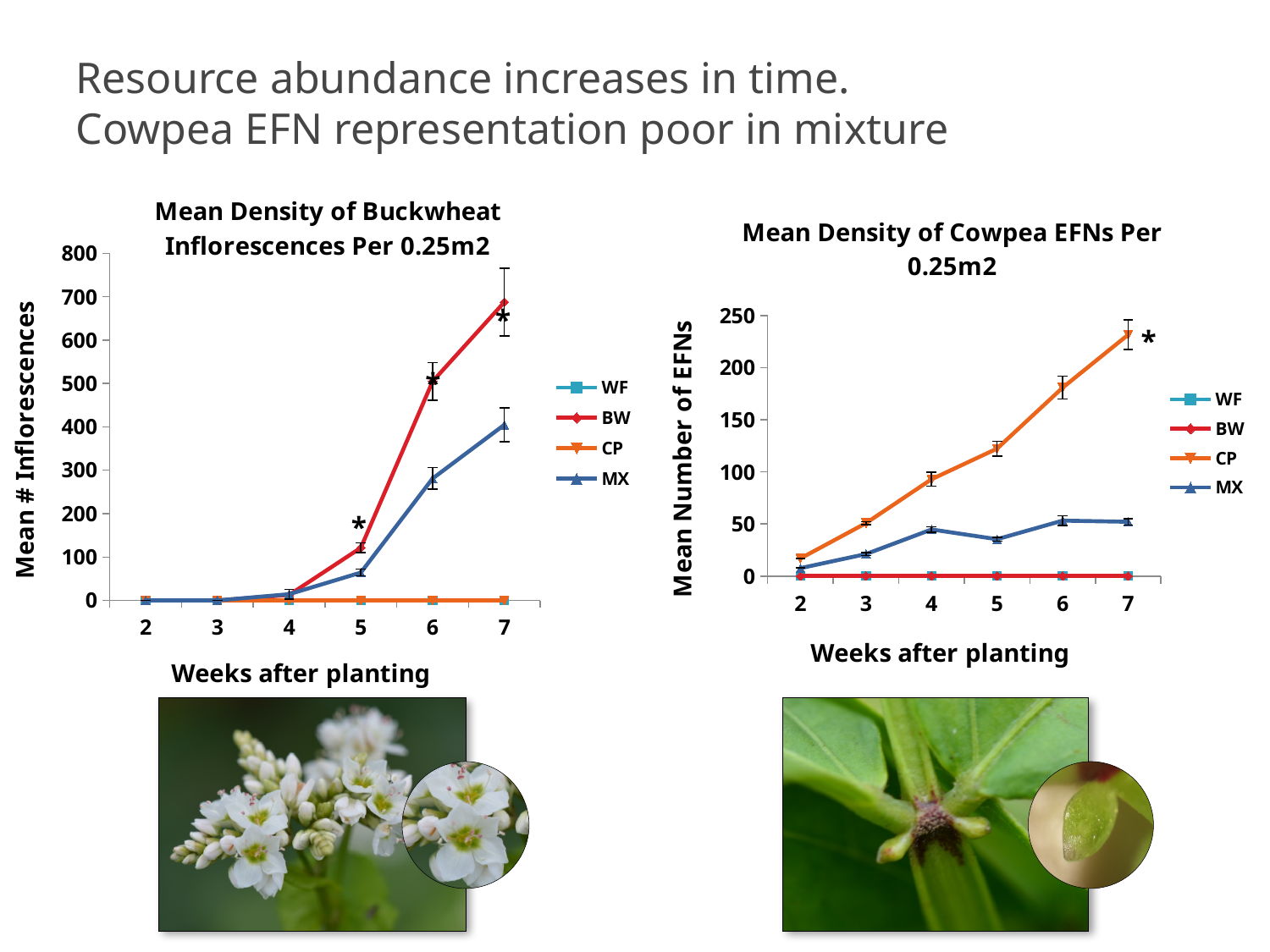
In the 'Mean Density of Cowpea EFNs Per 0.25m2' chart, does the CP series rise or fall from week 2 to week 7? rise In the 'Mean Density of Cowpea EFNs Per 0.25m2' chart, which series has the highest value at week 7? CP In the 'Mean Density of Buckwheat Inflorescences Per 0.25m2' chart, which series has the highest value at week 7? BW In the 'Mean Density of Buckwheat Inflorescences Per 0.25m2' chart, which is larger at week 7, BW or MX? BW What is the x-axis label of the 'Mean Density of Cowpea EFNs Per 0.25m2' chart? Weeks after planting In the 'Mean Density of Cowpea EFNs Per 0.25m2' chart, is the MX value at week 7 greater or less than 100? less How many weeks are plotted along the x axis of the 'Mean Density of Buckwheat Inflorescences Per 0.25m2' chart? 6 In the 'Mean Density of Buckwheat Inflorescences Per 0.25m2' chart, is the BW value at week 7 greater or less than 600? greater How many series does the legend of the 'Mean Density of Cowpea EFNs Per 0.25m2' chart list? 4 In the 'Mean Density of Cowpea EFNs Per 0.25m2' chart, is the CP value at week 7 greater or less than 200? greater What kind of chart is the 'Mean Density of Buckwheat Inflorescences Per 0.25m2' chart? line chart